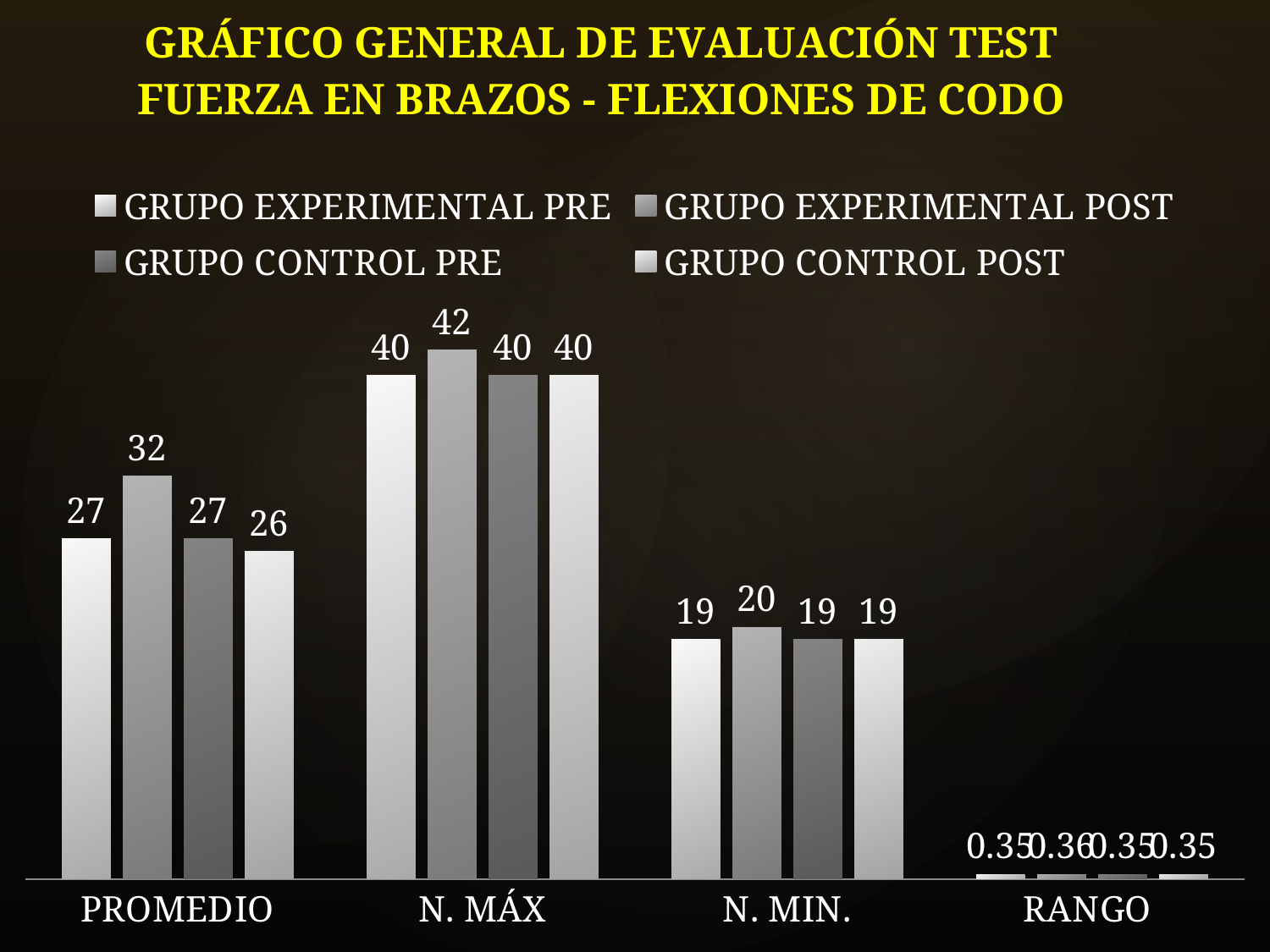
What is the value for GRUPO EXPERIMENTAL POST in the N. MÁX category? 42 What is the value for GRUPO EXPERIMENTAL POST in the PROMEDIO category? 32 What is the difference between GRUPO EXPERIMENTAL POST and GRUPO EXPERIMENTAL PRE in the PROMEDIO category? 5 What kind of chart is shown on the slide? Bar chart How many categories are shown on the x axis? 4 Which category has the lowest values overall? RANGO What is the value for GRUPO CONTROL POST in the PROMEDIO category? 26 Which series has the highest value in the N. MÁX category? GRUPO EXPERIMENTAL POST How many series does the legend list? 4 What is the value for GRUPO EXPERIMENTAL PRE in the N. MIN. category? 19 Which is larger in the N. MIN. category: GRUPO EXPERIMENTAL POST or GRUPO CONTROL PRE? GRUPO EXPERIMENTAL POST What is the title of the chart? GRÁFICO GENERAL DE EVALUACIÓN TEST FUERZA EN BRAZOS - FLEXIONES DE CODO